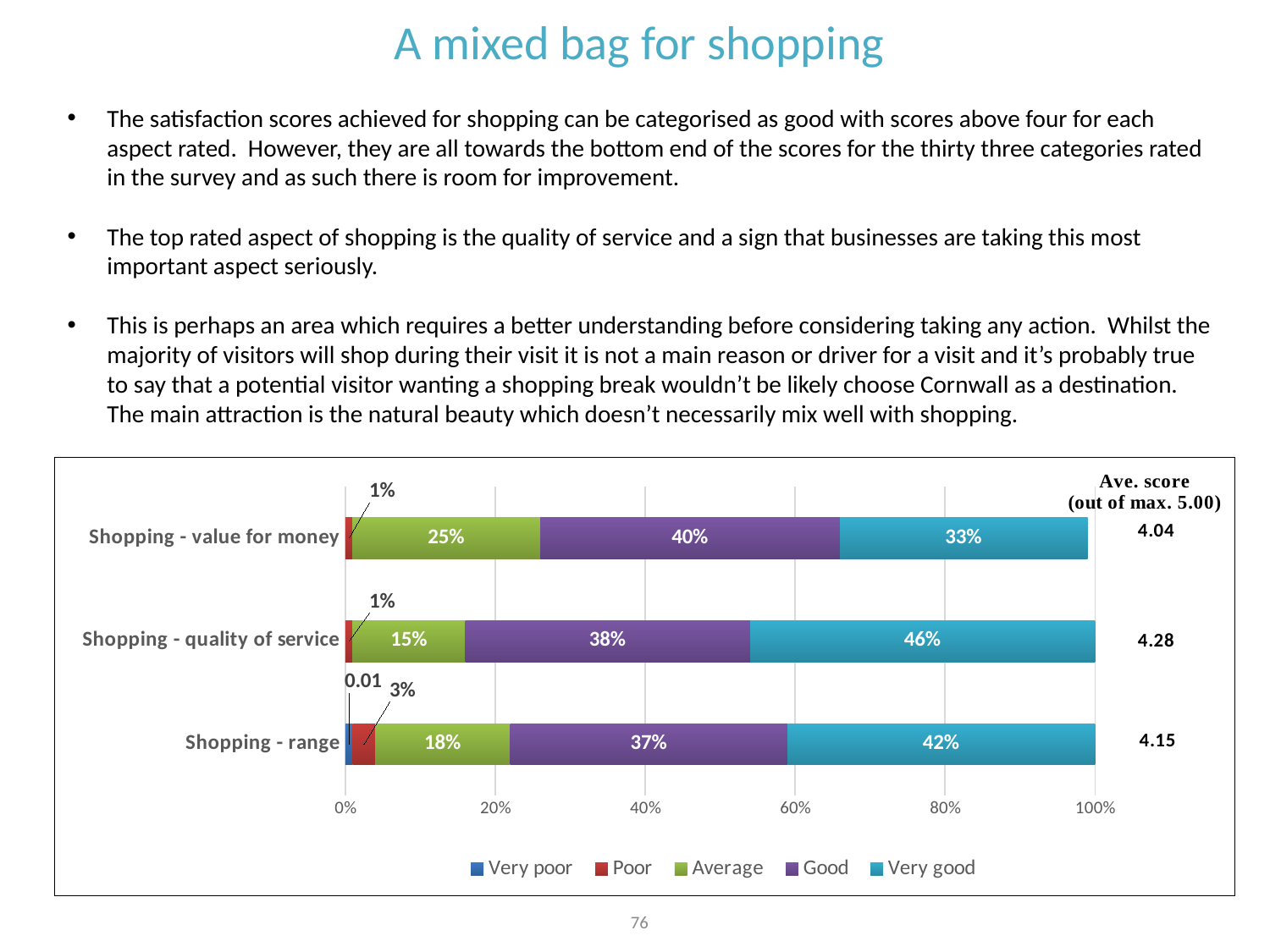
Which is larger: the 'Good' value for Shopping - value for money or the 'Good' value for Shopping - range? Shopping - value for money Which category has the lowest 'Average' share? Shopping - quality of service What is the difference between the 'Very good' values for Shopping - quality of service and Shopping - value for money? 13% Which category has the highest 'Very good' share? Shopping - quality of service What is the 'Good' value for Shopping - range? 37% How many categories are plotted on the chart? 3 What is the 'Poor' value for Shopping - range? 3% What type of chart is shown on the slide? Stacked bar chart What is the 'Very good' value for Shopping - quality of service? 46% How many series does the legend list? 5 What average score (out of max. 5.00) is shown for Shopping - quality of service? 4.28 What is the 'Average' value for Shopping - value for money? 25%